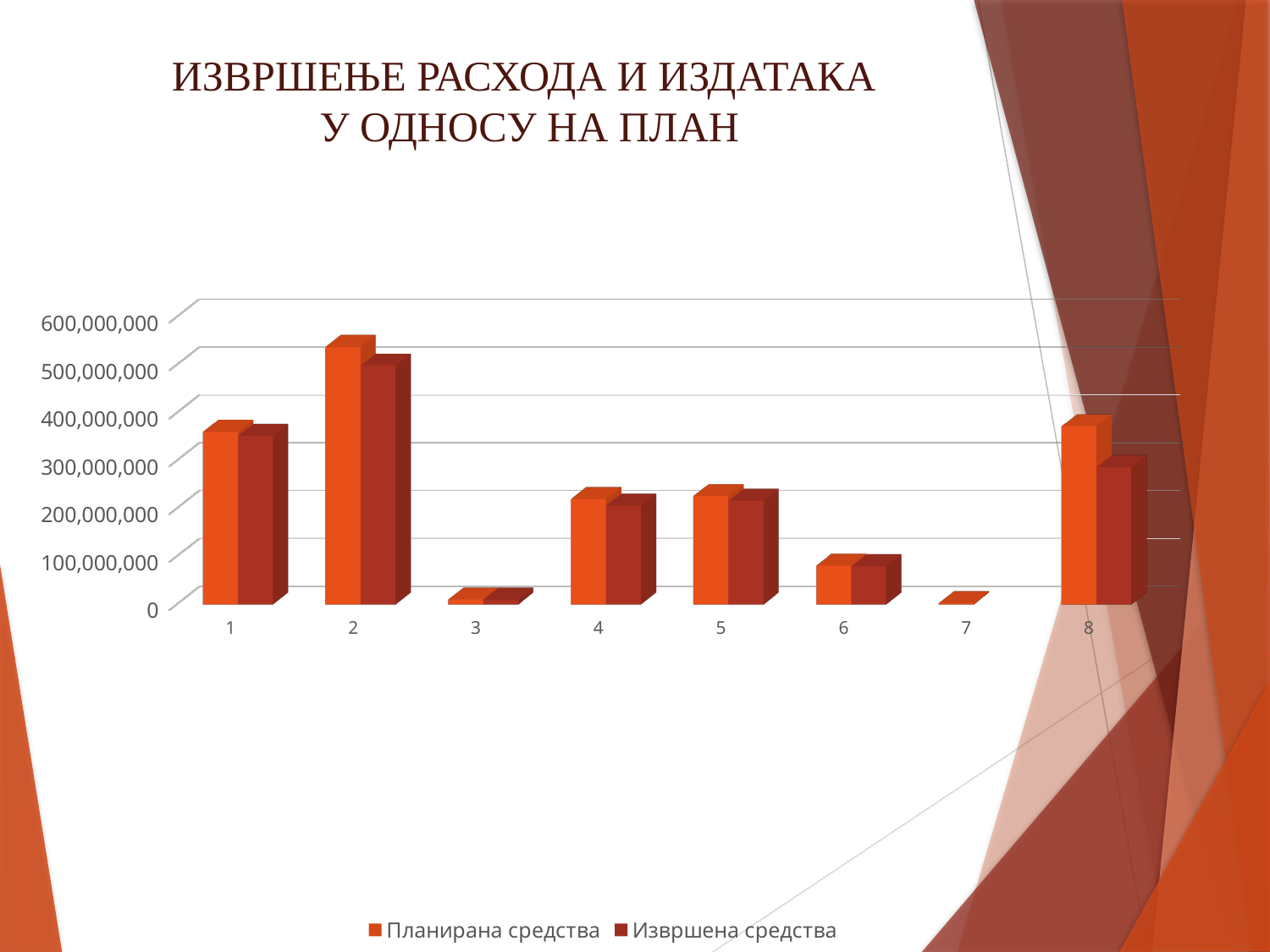
Is the value for Планирана средства in category 6 greater or less than 100,000,000? less What are the two series named in the legend? Планирана средства and Извршена средства Which is larger in category 8: Планирана средства or Извршена средства? Планирана средства How many categories are shown on the x axis of the chart? 8 Which category has the lowest value for Планирана средства? 7 What kind of chart is shown on the slide? bar chart Is the value for Планирана средства in category 2 greater or less than 500,000,000? greater Which category has the highest value for Планирана средства? 2 Which is larger: Планирана средства for category 1 or Планирана средства for category 4? category 1 How many series does the legend list? 2 Which category has the highest value for Извршена средства? 2